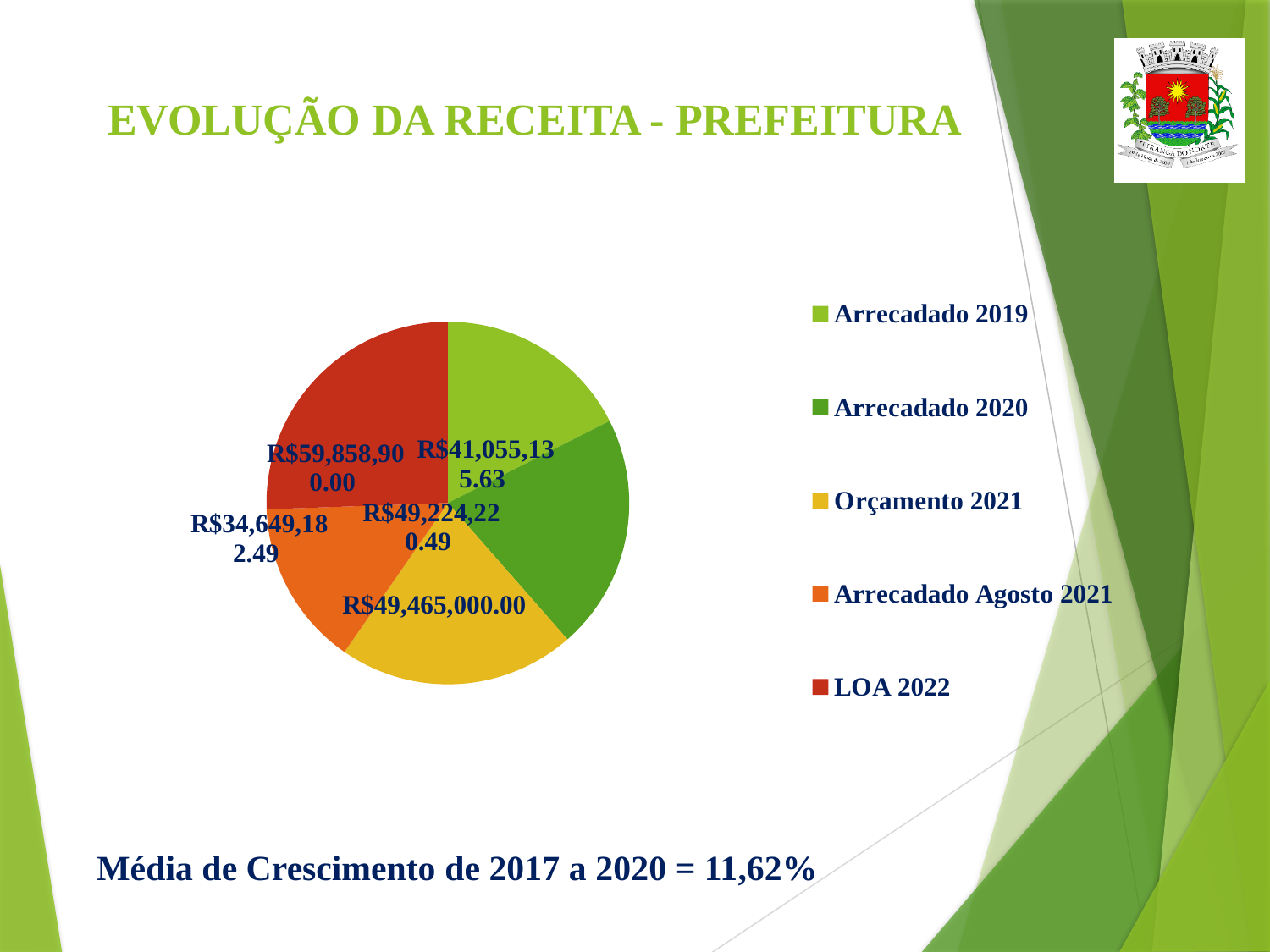
What is the value shown for Arrecadado 2019? R$41,055,135.63 Which is larger, the value for LOA 2022 or the value for Arrecadado 2019? LOA 2022 How many slices does the pie chart have? 5 What is the title of the chart on the slide? EVOLUÇÃO DA RECEITA - PREFEITURA What is the value shown for Orçamento 2021? R$49,465,000.00 What is the value shown for LOA 2022? R$59,858,900.00 Which category has the smallest slice of the pie? Arrecadado Agosto 2021 How many entries does the legend list? 5 What is the difference between the value for LOA 2022 and the value for Arrecadado 2019? R$18,803,764.37 What type of chart is shown on the slide? Pie chart What is the value shown for Arrecadado Agosto 2021? R$34,649,182.49 Which category has the largest slice of the pie? LOA 2022